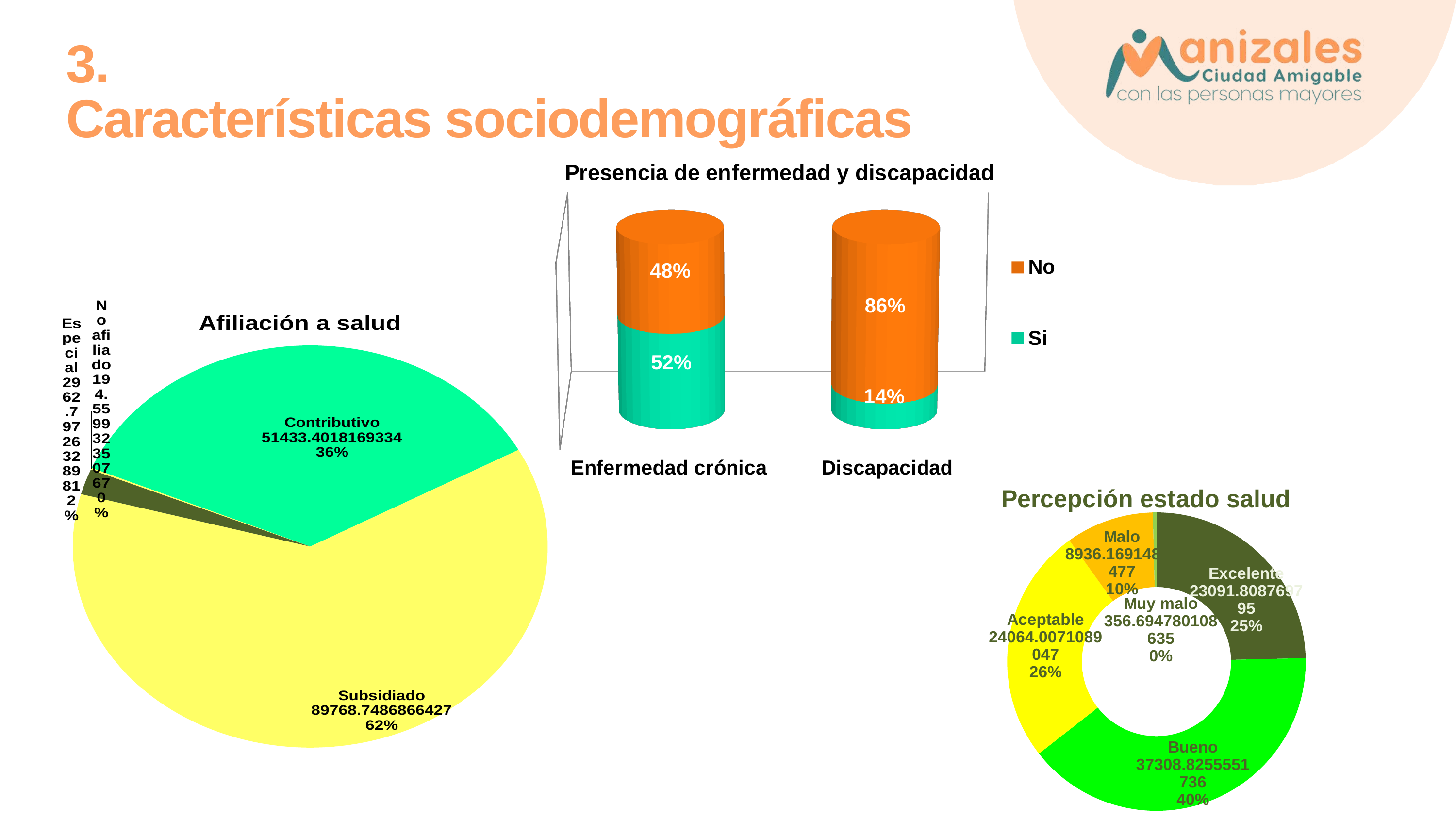
In the 'Percepción estado salud' chart, which category has the smallest share? Muy malo In the 'Presencia de enfermedad y discapacidad' chart, what is the 'Si' value for Enfermedad crónica? 52% In the 'Presencia de enfermedad y discapacidad' chart, what is the 'No' value for Discapacidad? 86% In the 'Percepción estado salud' chart, what percentage share does Bueno have? 40% How many series does the legend of the 'Presencia de enfermedad y discapacidad' chart list? 2 In the 'Afiliación a salud' chart, what percentage share does Contributivo have? 36% What kind of chart is 'Afiliación a salud'? Pie chart In the 'Presencia de enfermedad y discapacidad' chart, which category has the larger 'Si' value, Enfermedad crónica or Discapacidad? Enfermedad crónica In the 'Afiliación a salud' chart, what percentage share does Subsidiado have? 62% In the 'Afiliación a salud' chart, which category has the largest slice? Subsidiado In the 'Presencia de enfermedad y discapacidad' chart, what is the difference between the 'No' values for Discapacidad and Enfermedad crónica? 38% How many categories are shown in the 'Percepción estado salud' chart? 5